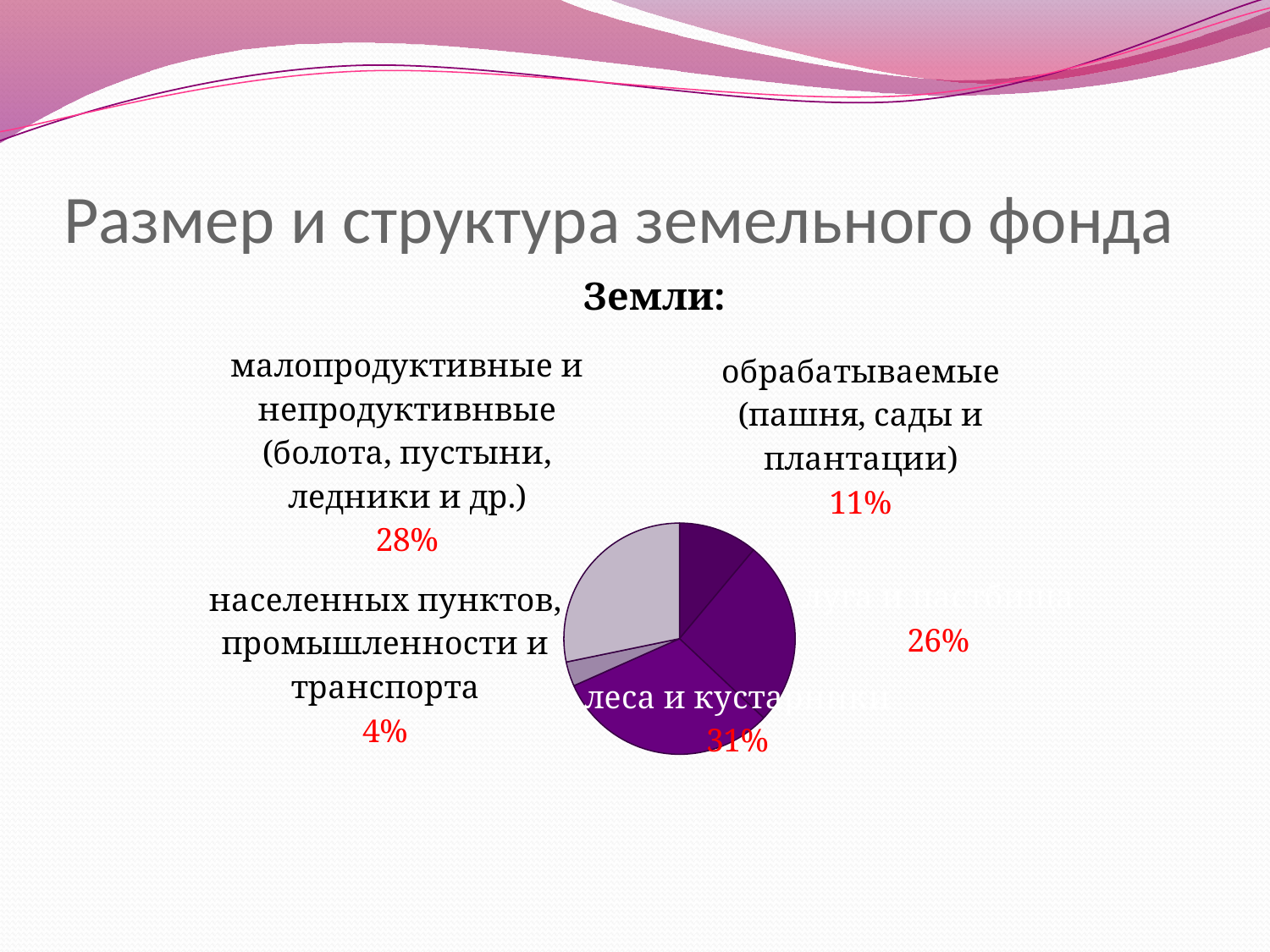
By how many percentage points does 'леса и кустарники' exceed 'малопродуктивные и непродуктивнвые'? 3 percentage points What value is shown for 'населенных пунктов, промышленности и транспорта'? 4% What percentage of the pie chart is labelled 'леса и кустарники'? 31% What percentage is given for 'малопродуктивные и непродуктивнвые (болота, пустыни, ледники и др.)'? 28% What is the title of the chart? Земли: Which category has the smallest share of the pie chart? населенных пунктов, промышленности и транспорта What is the difference between the 28% slice and the 4% slice? 24 percentage points Which is larger: the share for 'малопродуктивные и непродуктивнвые' or for 'обрабатываемые (пашня, сады и плантации)'? малопродуктивные и непродуктивнвые What type of chart is shown on the slide? pie chart Which category has the largest share of the pie chart? леса и кустарники What share of the pie is 'обрабатываемые (пашня, сады и плантации)'? 11% How many slices does the pie chart have? 5